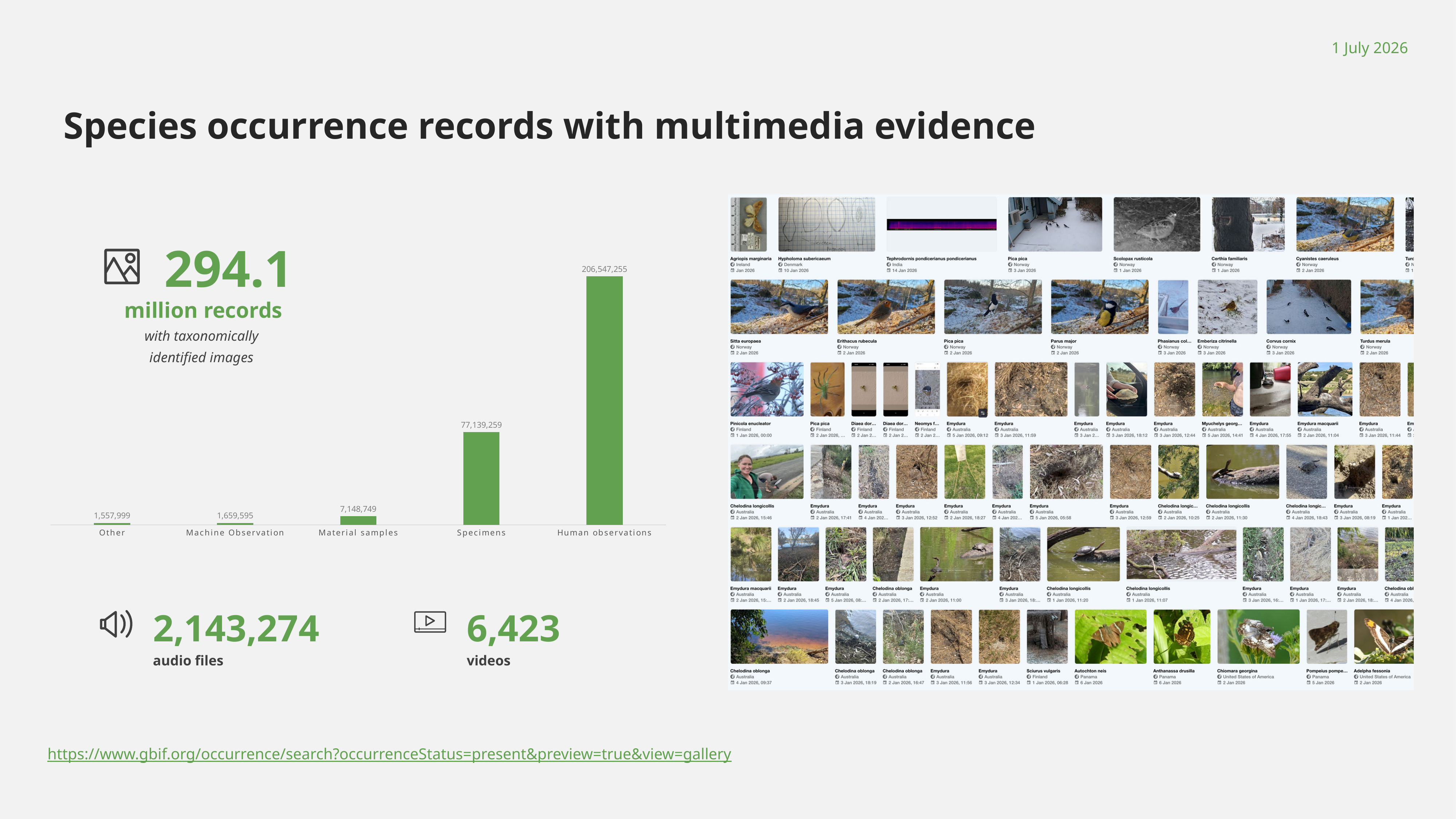
What type of chart is shown on the slide? bar chart What is the value for Material samples in the bar chart? 7,148,749 What is the value for Machine Observation in the bar chart? 1,659,595 Which category has the highest value in the bar chart? Human observations Which category has the lowest value in the bar chart? Other What is the difference between the values for Human observations and Specimens? 129,407,996 What is the value for Human observations in the bar chart? 206,547,255 What is the value for Other in the bar chart? 1,557,999 What is the value for Specimens in the bar chart? 77,139,259 How many categories does the bar chart show? 5 Do the values in the bar chart rise or fall from left to right along the x axis? rise Which is larger in the bar chart, Specimens or Material samples? Specimens